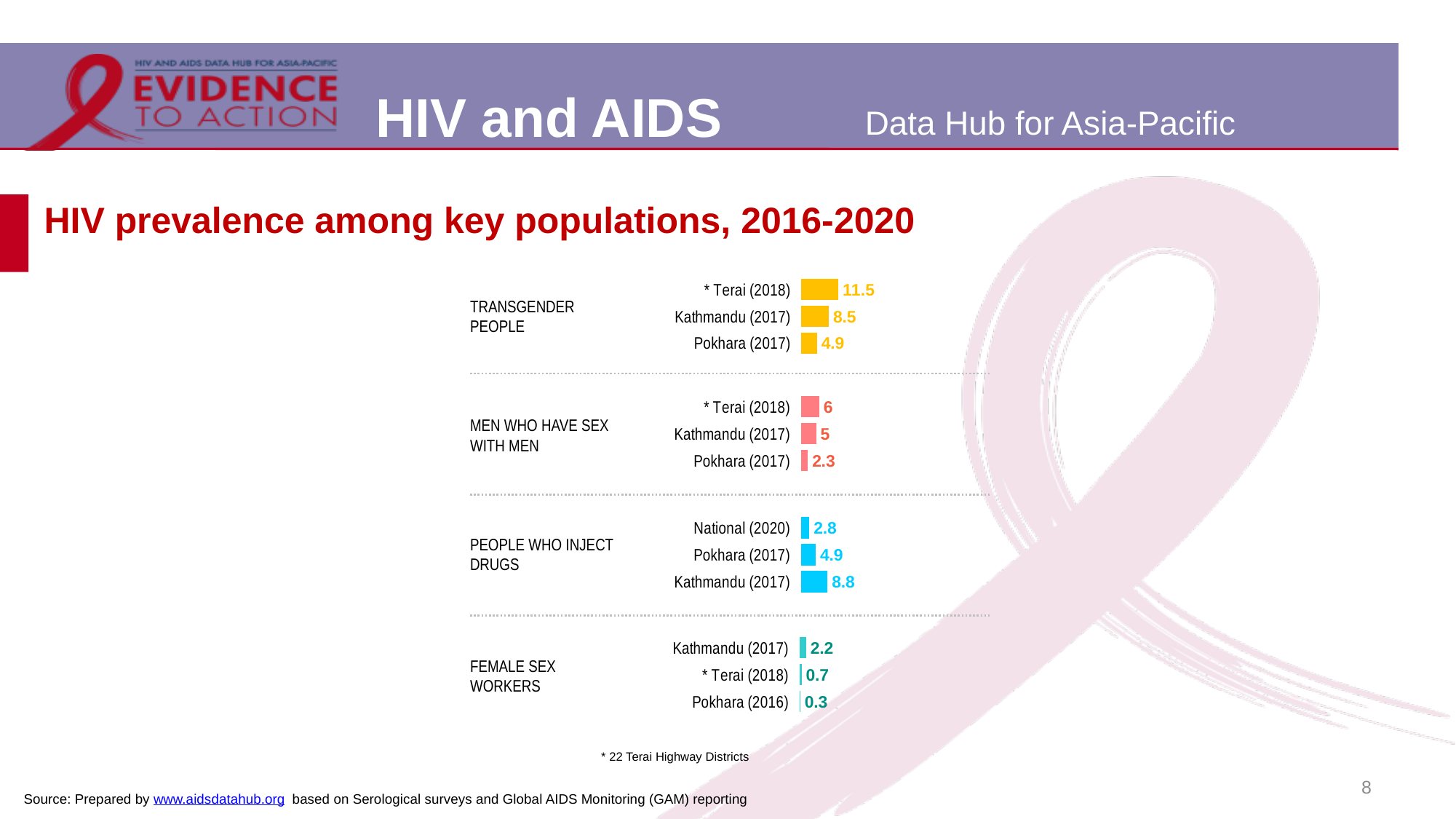
How many key population groups are shown in the chart? 4 What is the HIV prevalence among transgender people in Terai (2018)? 11.5 What type of chart is shown on the slide? Bar chart What is the HIV prevalence among female sex workers in Pokhara (2016)? 0.3 Which is larger: HIV prevalence among men who have sex with men in Terai (2018) or in Kathmandu (2017)? Terai (2018) What is the HIV prevalence among men who have sex with men in Pokhara (2017)? 2.3 Which bar in the chart has the lowest value? Female sex workers, Pokhara (2016) How many bars are plotted in the chart in total? 12 What is the HIV prevalence among people who inject drugs at the national level (2020)? 2.8 Which bar in the chart has the highest value? Transgender people, Terai (2018) What is the difference between the HIV prevalence among people who inject drugs in Kathmandu (2017) and in Pokhara (2017)? 3.9 What is the difference between the HIV prevalence among transgender people in Terai (2018) and in Kathmandu (2017)? 3